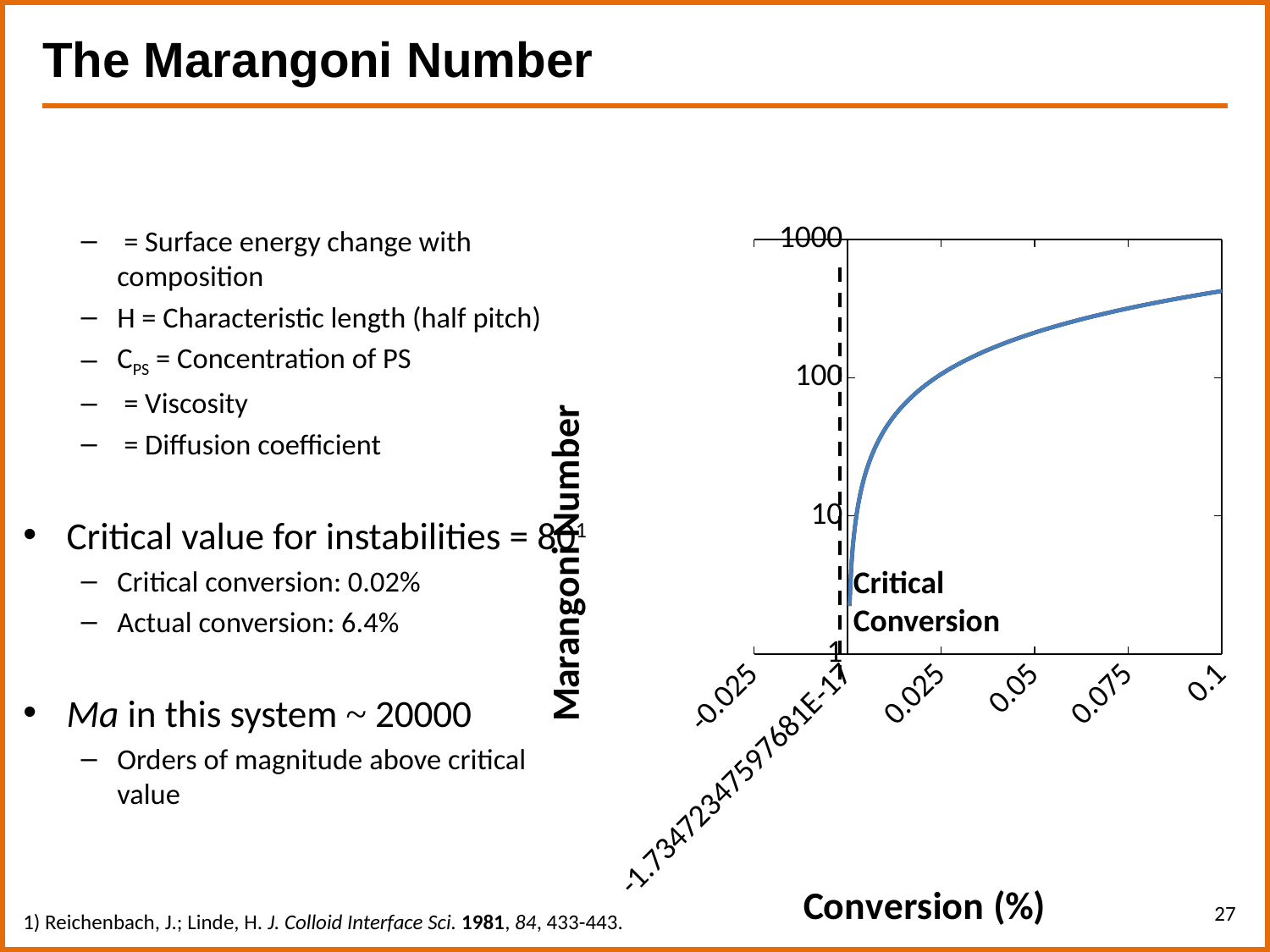
Is the Marangoni Number at a conversion of 0.05 greater or less than 100? greater What is the title of the x axis of the chart? Conversion (%) What kind of chart is shown on the slide? line chart What is the title of the y axis of the chart? Marangoni Number What is the highest tick value shown on the y axis of the chart? 1000 Is the Marangoni Number at a conversion of 0.1 greater or less than 100? greater Is the Marangoni Number at a conversion of 0.1 greater or less than 1000? less Which has the larger Marangoni Number: a conversion of 0.025 or a conversion of 0.1? 0.1 Does the Marangoni Number rise or fall as Conversion (%) increases along the x axis? rise How many tick labels are shown on the x axis of the chart? 6